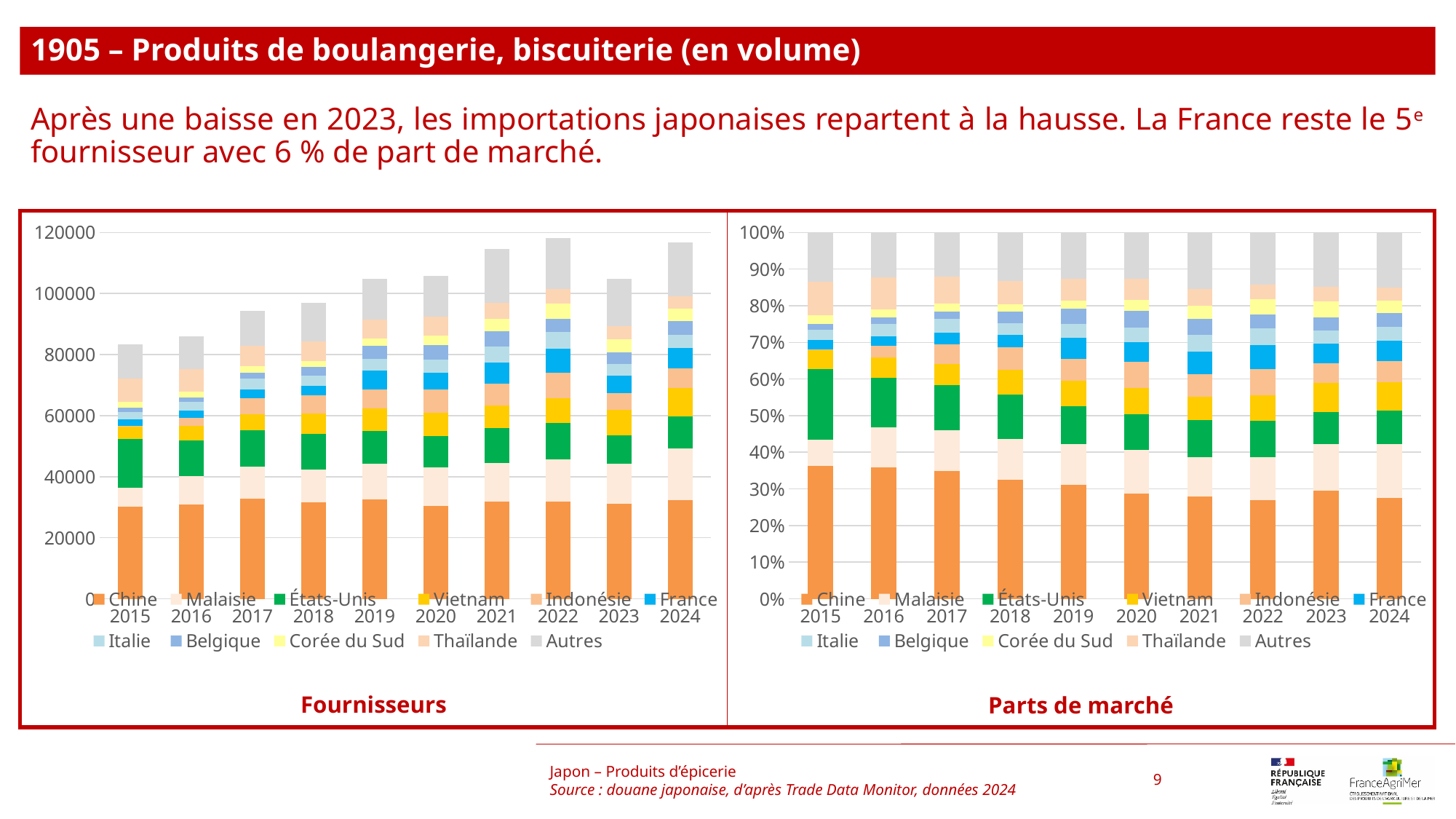
In the 'Parts de marché' chart, is the share for Chine larger in 2015 or in 2024? 2015 How many series does the legend of the 'Parts de marché' chart list? 11 How many years are shown on the x axis of the 'Fournisseurs' chart? 10 In the 'Fournisseurs' chart, is the total stacked value for 2016 greater or less than 100000? less In the 'Parts de marché' chart, is the share for Chine in 2022 greater or less than 30%? less In the 'Fournisseurs' chart, is the total stacked value for 2015 greater or less than 80000? greater In the 'Parts de marché' chart, does the share for Chine generally rise or fall from 2015 to 2024? fall In the 'Fournisseurs' chart, which year has the lowest total stacked value? 2015 What kind of chart is the 'Fournisseurs' chart? bar chart Which series is listed first in the legend of the 'Fournisseurs' chart? Chine